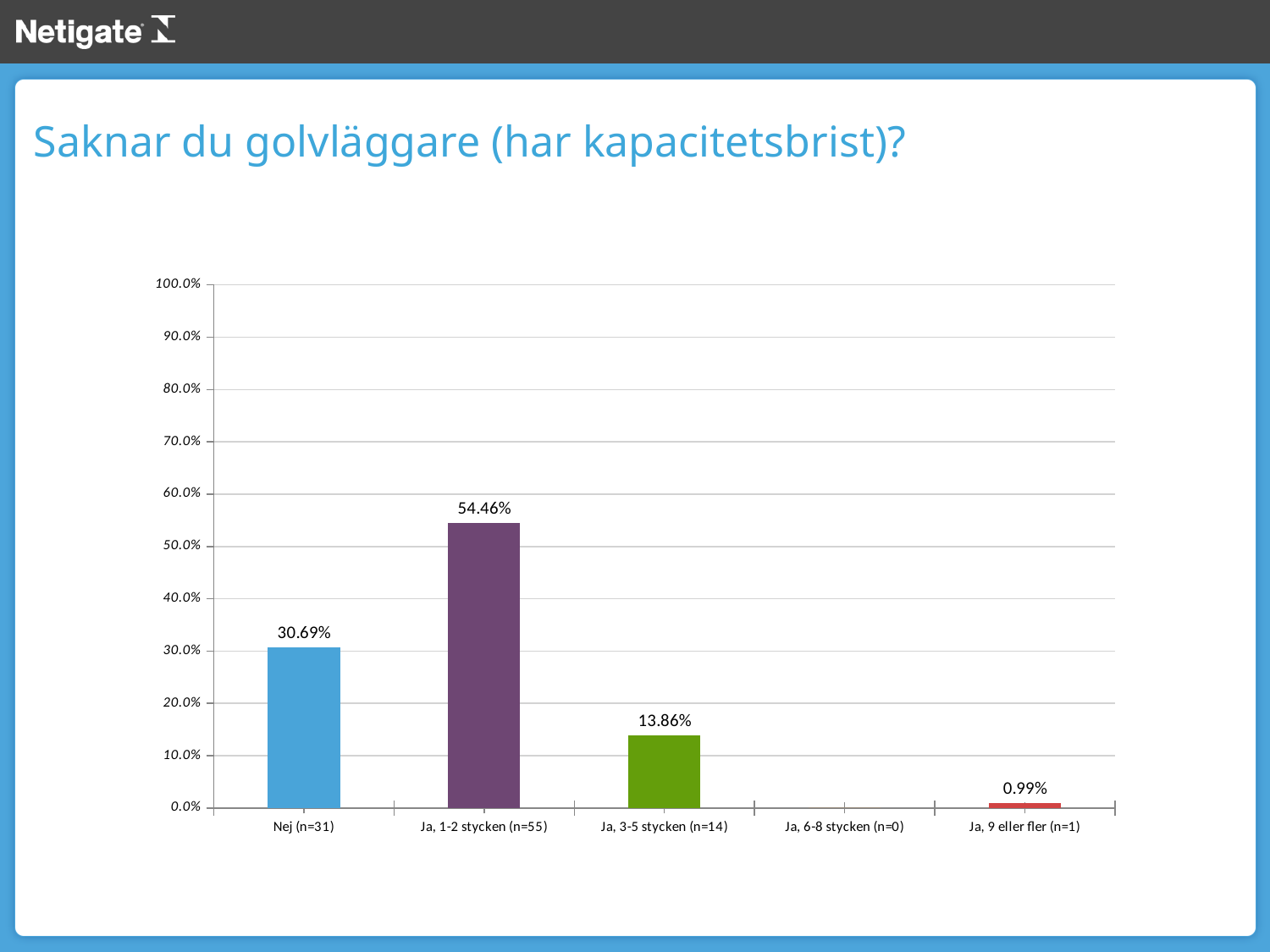
What is the value for "Ja, 3-5 stycken (n=14)"? 13.86% How many categories are shown on the x axis? 5 Is the value for "Ja, 1-2 stycken (n=55)" greater or less than 50.0%? greater What is the value for "Ja, 9 eller fler (n=1)"? 0.99% Which category has the highest value? Ja, 1-2 stycken (n=55) Which category has the lowest value? Ja, 6-8 stycken (n=0) What is the title of the slide? Saknar du golvläggare (har kapacitetsbrist)? What is the difference between the values for "Ja, 1-2 stycken (n=55)" and "Nej (n=31)"? 23.77% What is the value for "Nej (n=31)"? 30.69% What kind of chart is shown on the slide? bar chart What is the value for "Ja, 1-2 stycken (n=55)"? 54.46% Which is larger, the value for "Nej (n=31)" or the value for "Ja, 3-5 stycken (n=14)"? Nej (n=31)